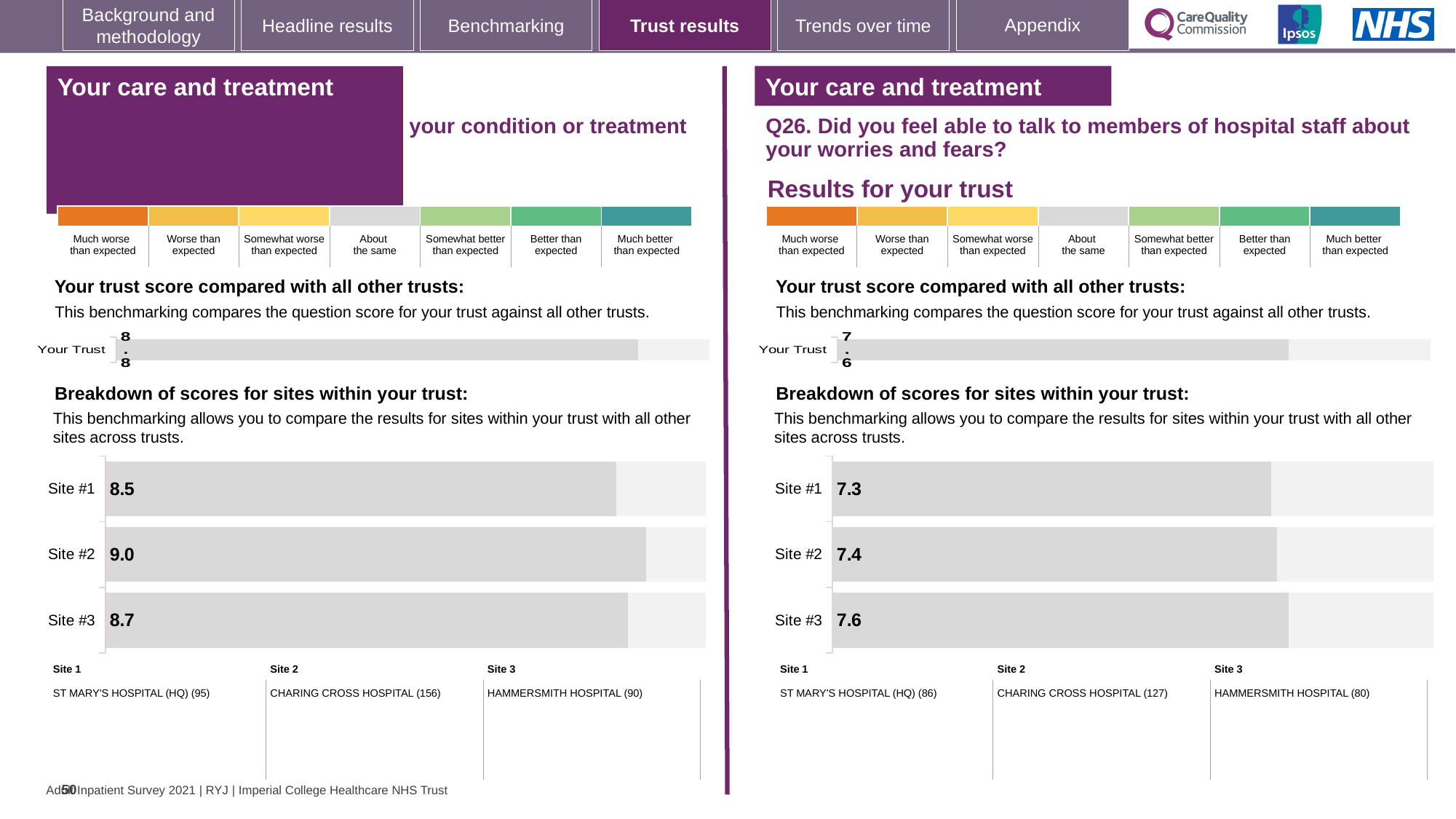
How many sites are shown on the right-hand (Q26) site breakdown chart? 3 On the right-hand (Q26) site breakdown chart, do the scores rise or fall from Site #1 to Site #3? Rise On the right-hand (Q26) 'Your trust score compared with all other trusts' chart, what is the value shown for Your Trust? 7.6 On the left-hand 'Breakdown of scores for sites within your trust' chart, what is the score for Site #2? 9.0 On the right-hand (Q26) site breakdown chart, which site has the lowest score? Site #1 On the left-hand site breakdown chart, what is the difference between the scores for Site #2 and Site #1? 0.5 On the left-hand site breakdown chart, which has the larger score, Site #1 or Site #3? Site #3 On the right-hand (Q26) site breakdown chart, what is the difference between the scores for Site #3 and Site #1? 0.3 On the left-hand 'Your trust score compared with all other trusts' chart, what is the value shown for Your Trust? 8.8 What type of chart is the left-hand 'Breakdown of scores for sites within your trust' chart? Bar chart On the left-hand site breakdown chart, which site has the highest score? Site #2 On the right-hand (Q26) 'Breakdown of scores for sites within your trust' chart, what is the score for Site #3? 7.6